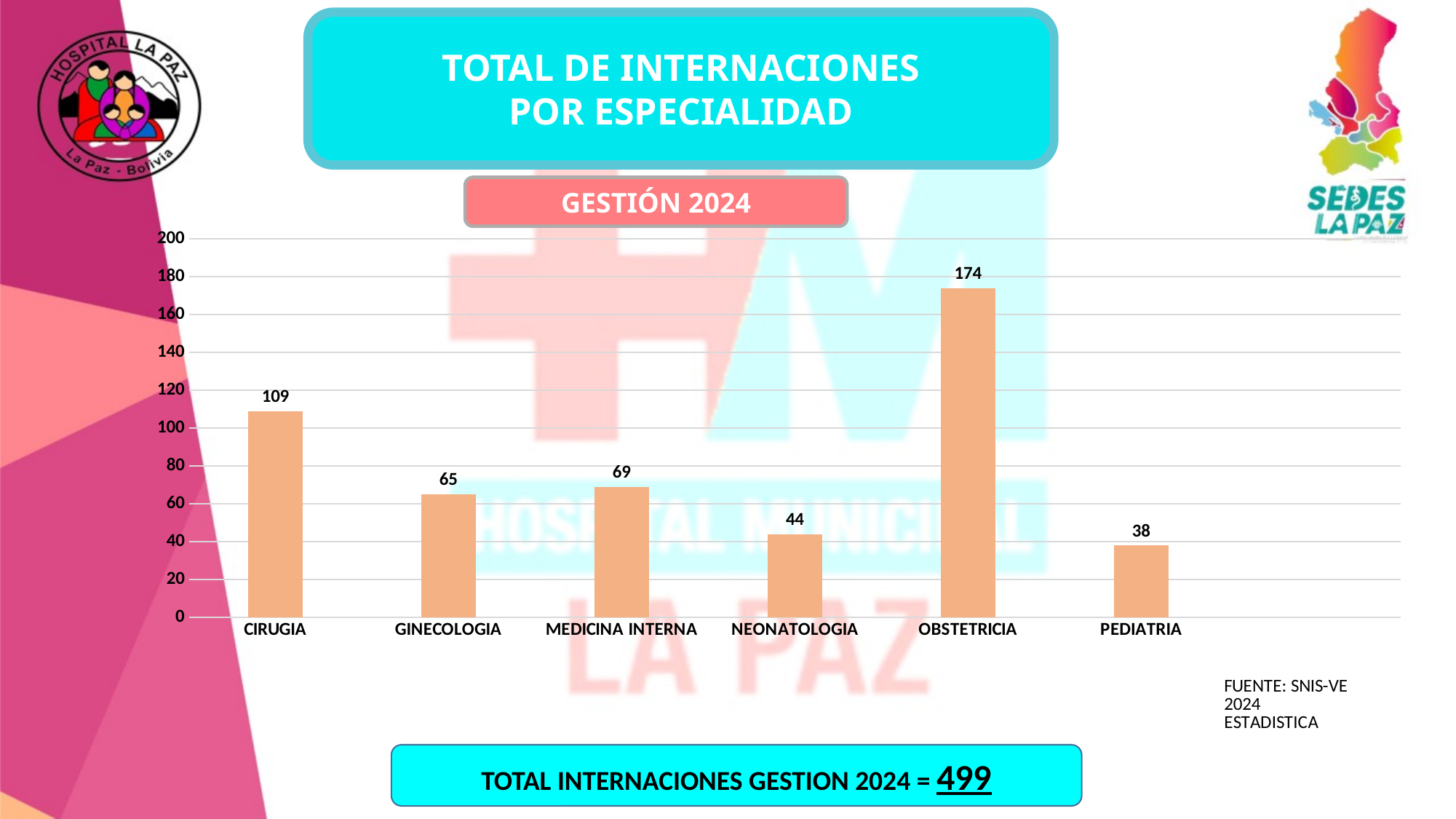
What is the value for PEDIATRIA? 38 What is the difference between the values for OBSTETRICIA and CIRUGIA? 65 What is the total of internaciones for gestión 2024 stated on the slide? 499 What kind of chart is shown on the slide? Bar chart What is the value for NEONATOLOGIA? 44 Which is larger, the value for GINECOLOGIA or the value for NEONATOLOGIA? GINECOLOGIA How many specialties are shown on the chart? 6 What is the value for OBSTETRICIA? 174 Which specialty has the lowest number of internaciones? PEDIATRIA What is the value for CIRUGIA? 109 Which specialty has the highest number of internaciones? OBSTETRICIA What is the difference between the values for MEDICINA INTERNA and GINECOLOGIA? 4